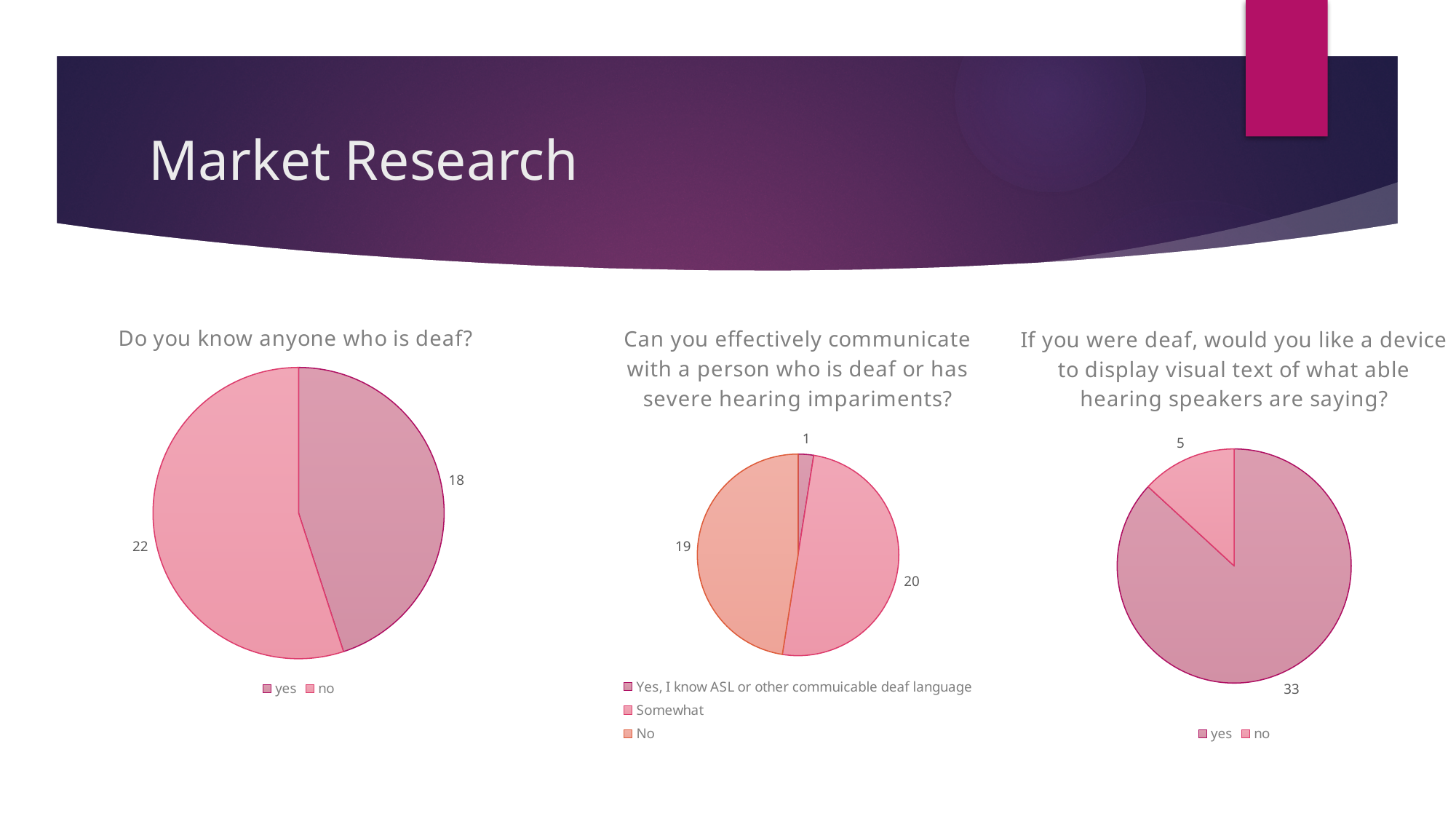
In the middle chart about effectively communicating with a person who is deaf, which category has the smallest value? Yes, I know ASL or other commuicable deaf language In the middle chart about effectively communicating with a person who is deaf, how many categories does the legend list? 3 In the chart titled "Do you know anyone who is deaf?", which category is larger, "yes" or "no"? no In the middle chart about effectively communicating with a person who is deaf, what is the value for "Somewhat"? 20 In the chart titled "Do you know anyone who is deaf?", what is the value for "yes"? 18 In the right-hand chart about wanting a device to display visual text, what is the difference between the "yes" and "no" values? 28 In the chart titled "Do you know anyone who is deaf?", what is the difference between the "no" and "yes" values? 4 What kind of chart is used for the three charts on this slide? pie chart In the right-hand chart about wanting a device to display visual text, what is the value for "yes"? 33 In the chart titled "Do you know anyone who is deaf?", what share of the total does "yes" represent? 45% In the chart titled "Do you know anyone who is deaf?", what is the value for "no"? 22 In the middle chart about effectively communicating with a person who is deaf, what is the total of all slices? 40